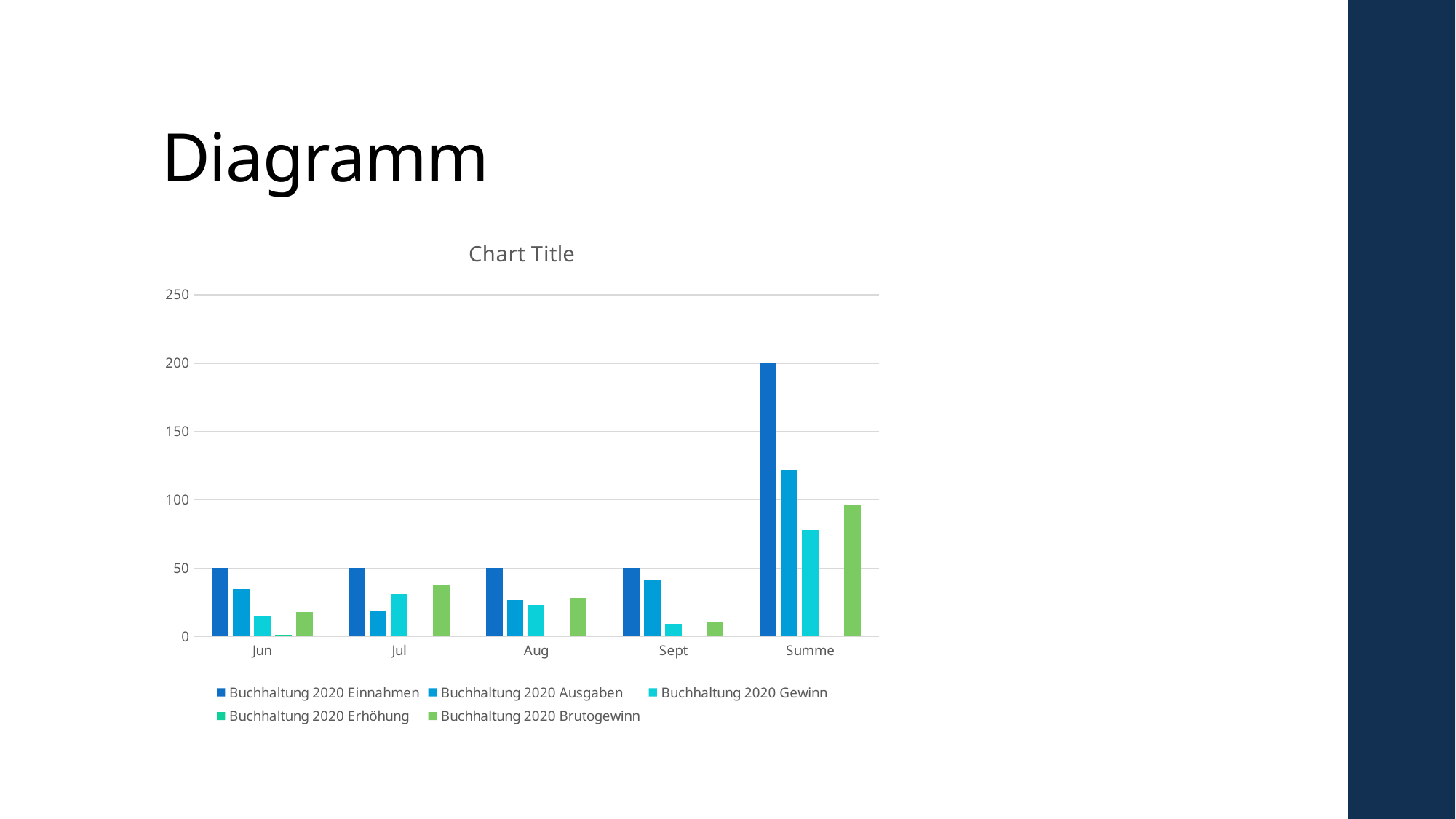
What is the value of Buchhaltung 2020 Einnahmen for Summe? 200 What is the title of the chart? Chart Title Which category has the highest value for Buchhaltung 2020 Einnahmen? Summe Which is larger for Aug: Buchhaltung 2020 Einnahmen or Buchhaltung 2020 Ausgaben? Buchhaltung 2020 Einnahmen Is the value of Buchhaltung 2020 Gewinn for Sept greater or less than 50? less How many series does the chart legend list? 5 What is the value of Buchhaltung 2020 Einnahmen for Jun? 50 Which category has the lowest value for Buchhaltung 2020 Brutogewinn? Sept What kind of chart is shown on the slide? bar chart Is the value of Buchhaltung 2020 Ausgaben for Summe greater or less than 100? greater Which is larger for Jul: Buchhaltung 2020 Ausgaben or Buchhaltung 2020 Brutogewinn? Buchhaltung 2020 Brutogewinn How many categories are shown on the x axis of the chart? 5